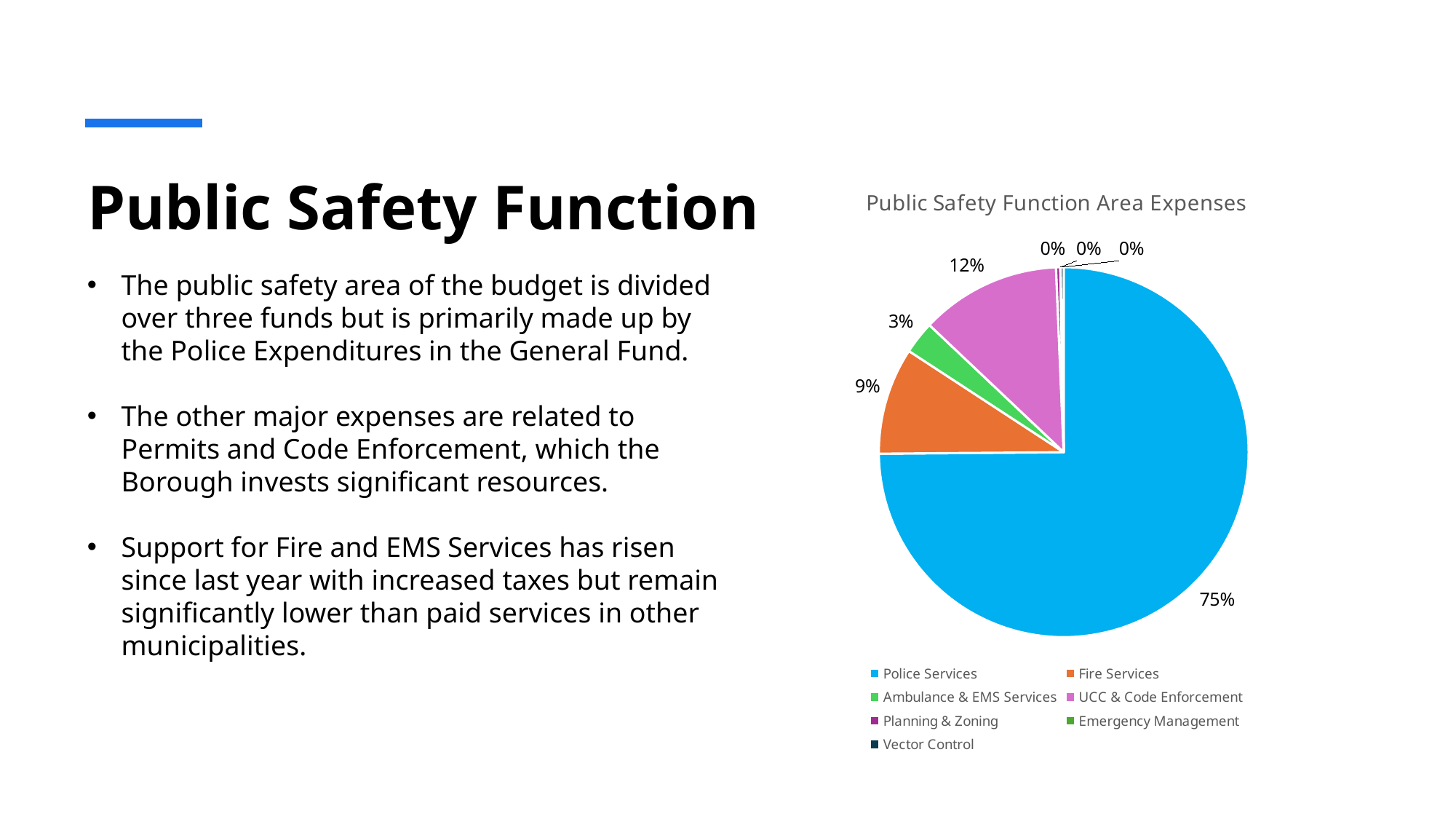
What is the difference in percentage points between the Fire Services share and the Ambulance & EMS Services share? 6 What is the title of the chart? Public Safety Function Area Expenses What share of the pie does Fire Services represent? 9% How many categories does the legend list? 7 Which category has the largest share of the pie? Police Services What type of chart is shown on the slide? Pie chart Which is larger, the share for Fire Services or the share for UCC & Code Enforcement? UCC & Code Enforcement What share of the pie does Police Services represent? 75% What share of the pie does Ambulance & EMS Services represent? 3% What colour is the Police Services slice? Blue What is the difference in percentage points between the Police Services share and the UCC & Code Enforcement share? 63